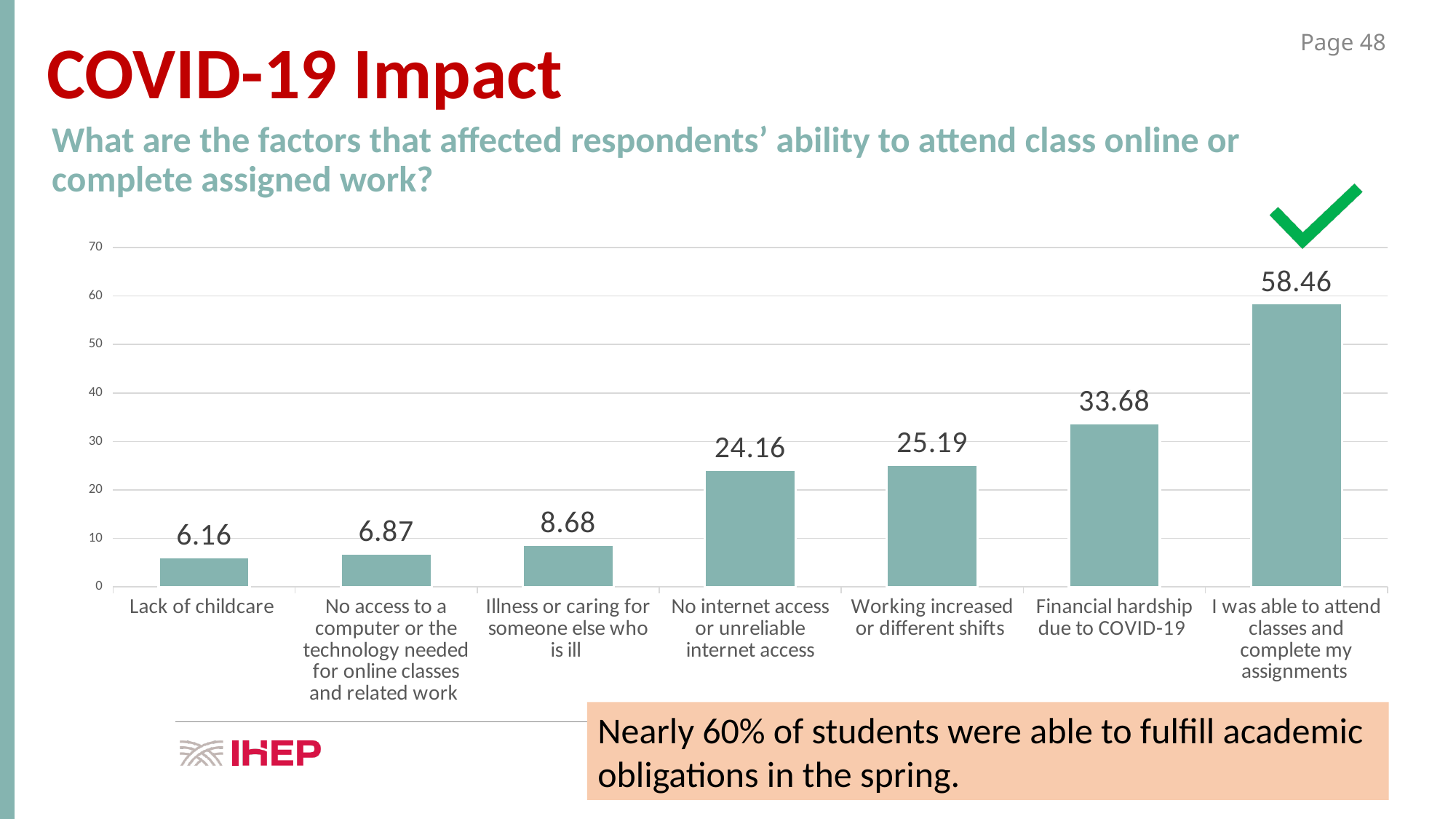
How many categories are shown in the chart? 7 What is the value for "Financial hardship due to COVID-19"? 33.68 What kind of chart is shown on the slide? bar chart Which category has the highest value? I was able to attend classes and complete my assignments Which category has the lowest value? Lack of childcare What is the difference between the values for "Financial hardship due to COVID-19" and "Working increased or different shifts"? 8.49 What is the highest value shown on the vertical axis? 70 What is the value for "Lack of childcare"? 6.16 What is the value for "No internet access or unreliable internet access"? 24.16 Is the value for "I was able to attend classes and complete my assignments" greater or less than 50? greater Which is larger: the value for "Illness or caring for someone else who is ill" or the value for "No access to a computer or the technology needed for online classes and related work"? Illness or caring for someone else who is ill Do the values rise or fall from left to right along the x axis? rise